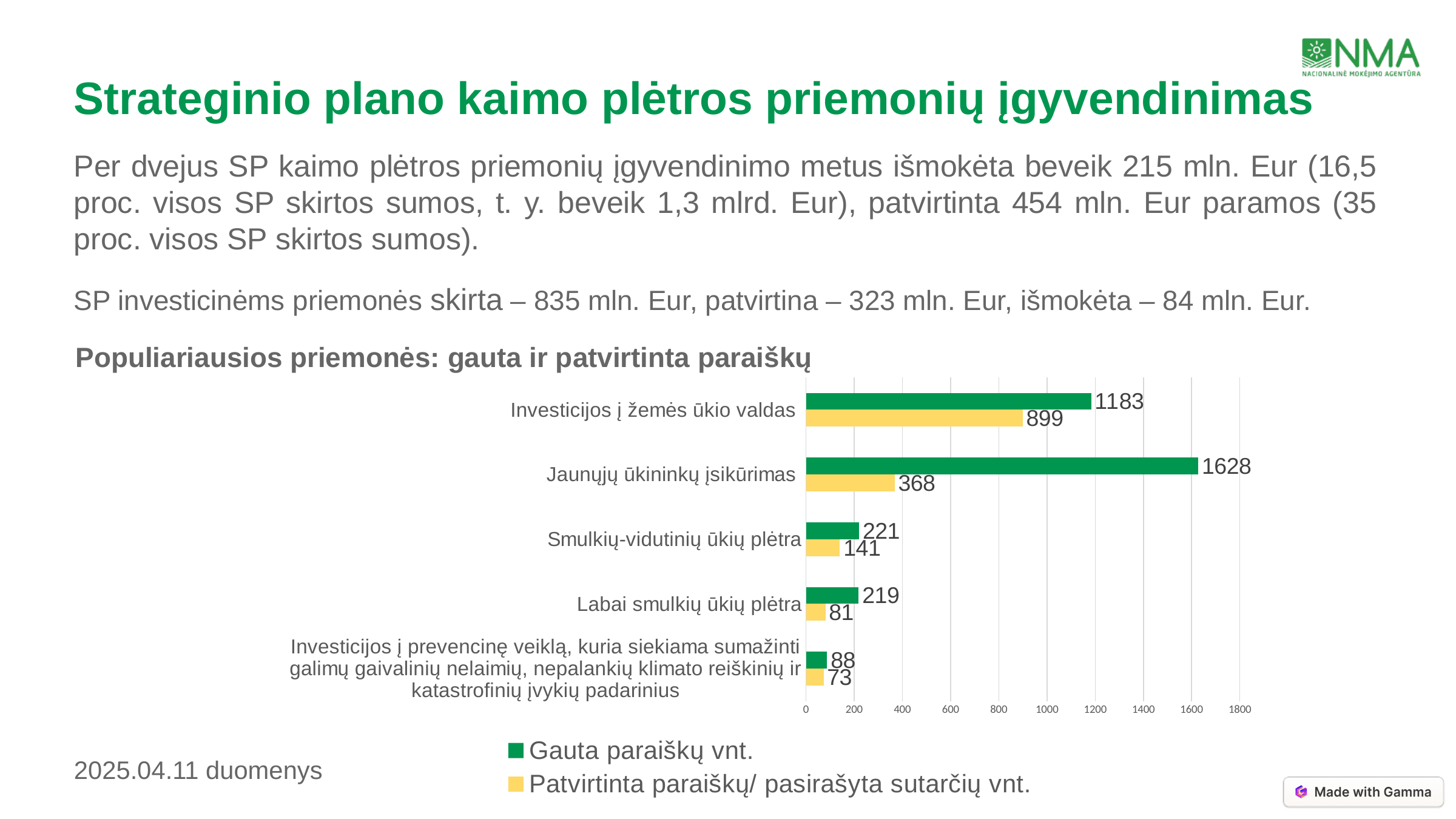
How many series does the chart legend list? 2 Which is larger: "Gauta paraiškų vnt." for "Investicijos į žemės ūkio valdas" or for "Jaunųjų ūkininkų įsikūrimas"? Jaunųjų ūkininkų įsikūrimas What is the value of "Gauta paraiškų vnt." for "Jaunųjų ūkininkų įsikūrimas"? 1628 What is the difference between "Gauta paraiškų vnt." and "Patvirtinta paraiškų/ pasirašyta sutarčių vnt." for "Jaunųjų ūkininkų įsikūrimas"? 1260 Which category has the highest value of "Gauta paraiškų vnt."? Jaunųjų ūkininkų įsikūrimas Is the value of "Gauta paraiškų vnt." for "Investicijos į žemės ūkio valdas" greater or less than 1000? greater What colour are the bars for "Gauta paraiškų vnt."? green What is the value of "Patvirtinta paraiškų/ pasirašyta sutarčių vnt." for "Investicijos į žemės ūkio valdas"? 899 Which category has the lowest value of "Patvirtinta paraiškų/ pasirašyta sutarčių vnt."? Investicijos į prevencinę veiklą, kuria siekiama sumažinti galimų gaivalinių nelaimių, nepalankių klimato reiškinių ir katastrofinių įvykių padarinius How many categories are shown in the chart? 5 What is the value of "Patvirtinta paraiškų/ pasirašyta sutarčių vnt." for "Labai smulkių ūkių plėtra"? 81 What kind of chart is shown on the slide? bar chart